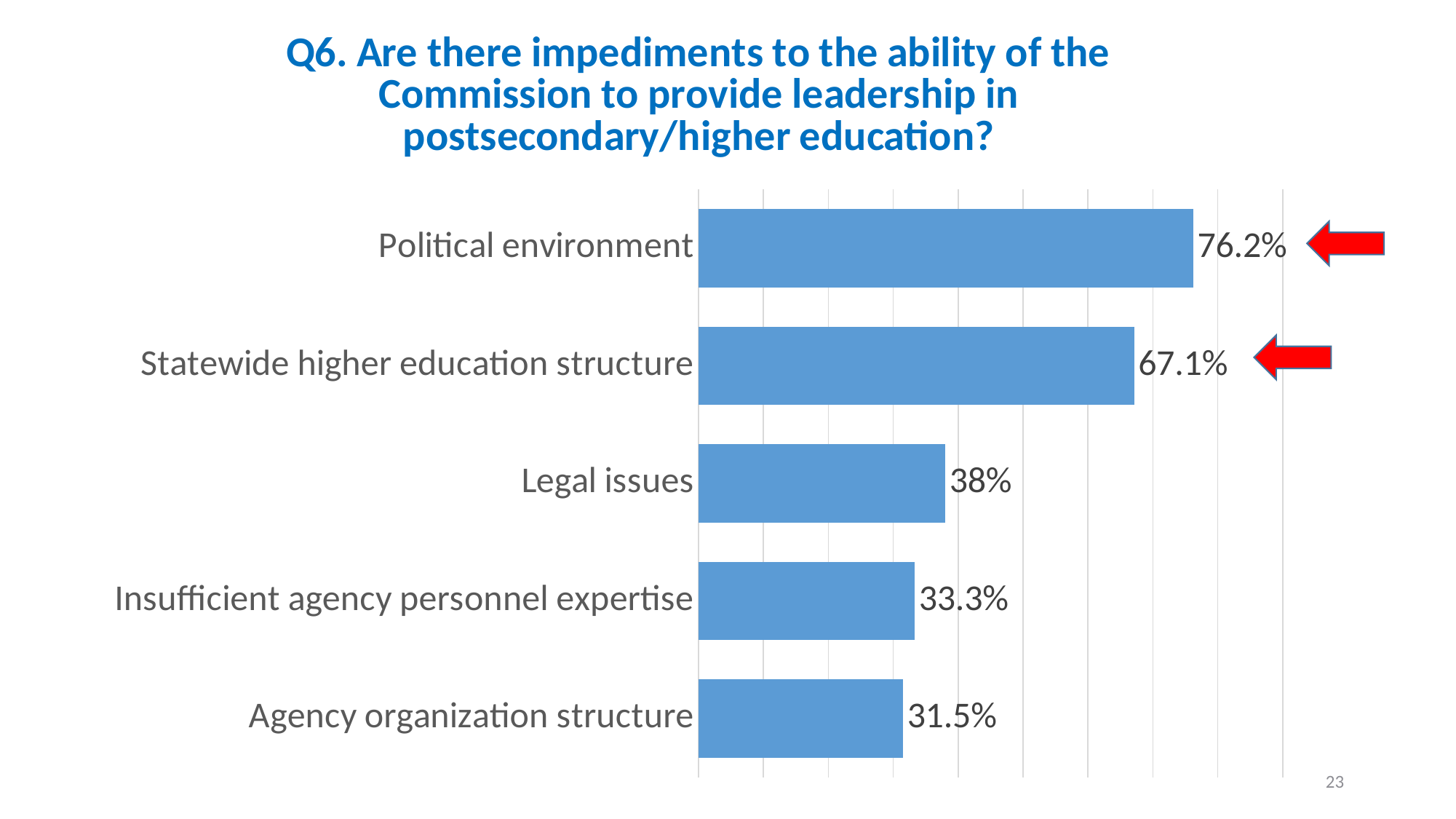
What is the value for Insufficient agency personnel expertise? 33.3% What is the value for Political environment? 76.2% How many categories are marked with a red arrow? 2 Which category has the highest value? Political environment Which category has the lowest value? Agency organization structure What is the value for Legal issues? 38% What is the value for Statewide higher education structure? 67.1% What is the value for Agency organization structure? 31.5% What is the difference between the values for Political environment and Statewide higher education structure? 9.1% Which is larger, the value for Legal issues or the value for Insufficient agency personnel expertise? Legal issues How many categories are shown in the chart? 5 What kind of chart is shown on the slide? Bar chart